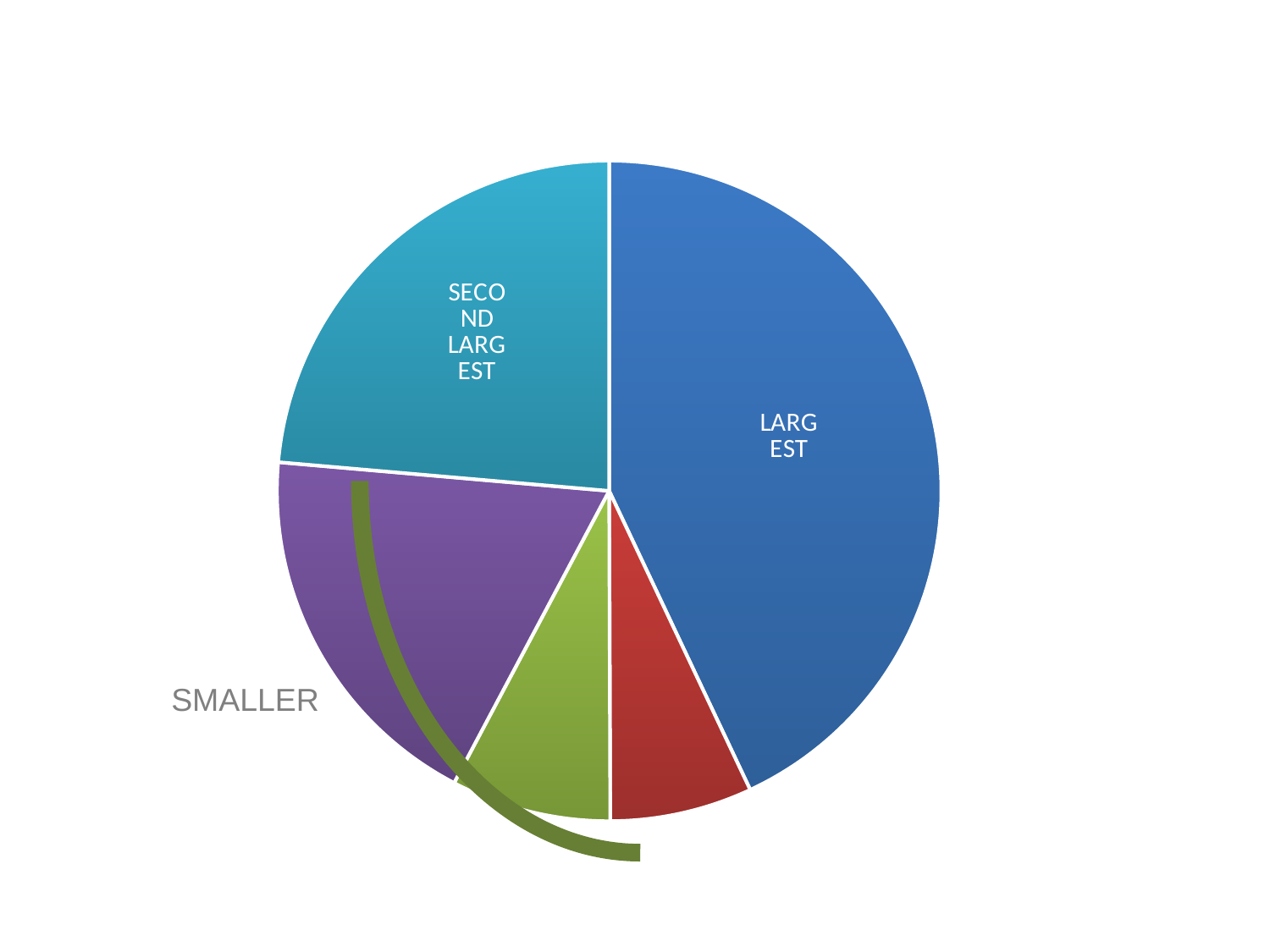
Which is larger in the pie chart, the blue slice or the teal slice? the blue slice Which slice of the pie chart is the largest? the blue slice labelled LARGEST What label is printed on the blue slice of the pie chart? LARGEST Which is larger in the pie chart, the teal slice or the purple slice? the teal slice What label is printed on the teal slice of the pie chart? SECOND LARGEST Which is larger in the pie chart, the purple slice or the green slice? the purple slice How many slices does the pie chart have? 5 What kind of chart is shown on the slide? pie chart